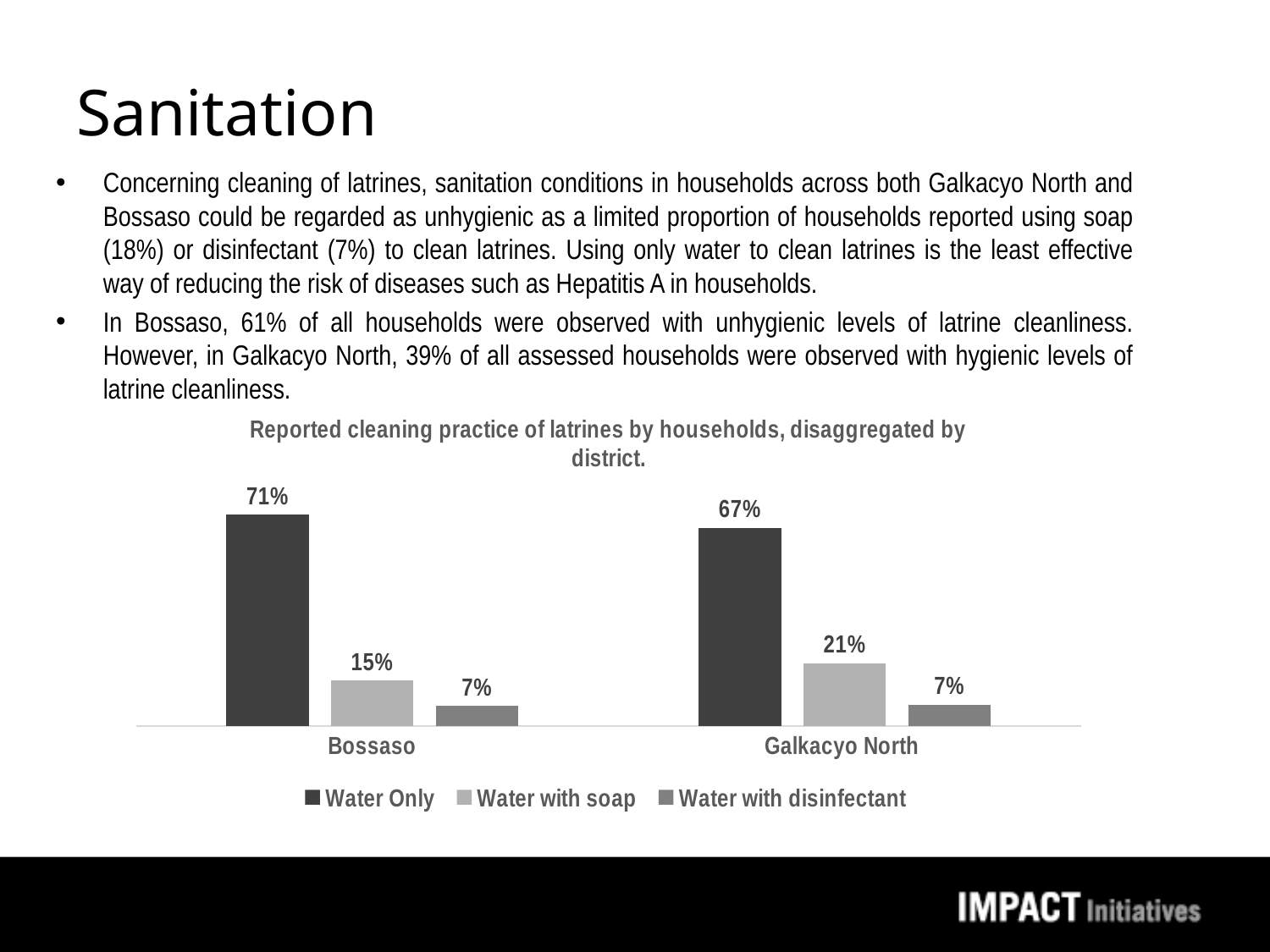
What percentage of households in Bossaso reported using Water Only to clean latrines? 71% Which cleaning practice has the highest value in Bossaso? Water Only What type of chart is shown on the slide? Bar chart What is the difference between the Water Only values for Bossaso and Galkacyo North? 4% What percentage of households in Galkacyo North reported using Water with disinfectant? 7% What percentage of households in Galkacyo North reported using Water with soap? 21% How many series does the legend list? 3 Which district has the higher value for Water with soap? Galkacyo North What is the difference between Water with soap and Water with disinfectant in Bossaso? 8% How many districts are shown on the x axis of the chart? 2 Which cleaning practice has the lowest value in Galkacyo North? Water with disinfectant What is the title of the chart? Reported cleaning practice of latrines by households, disaggregated by district.